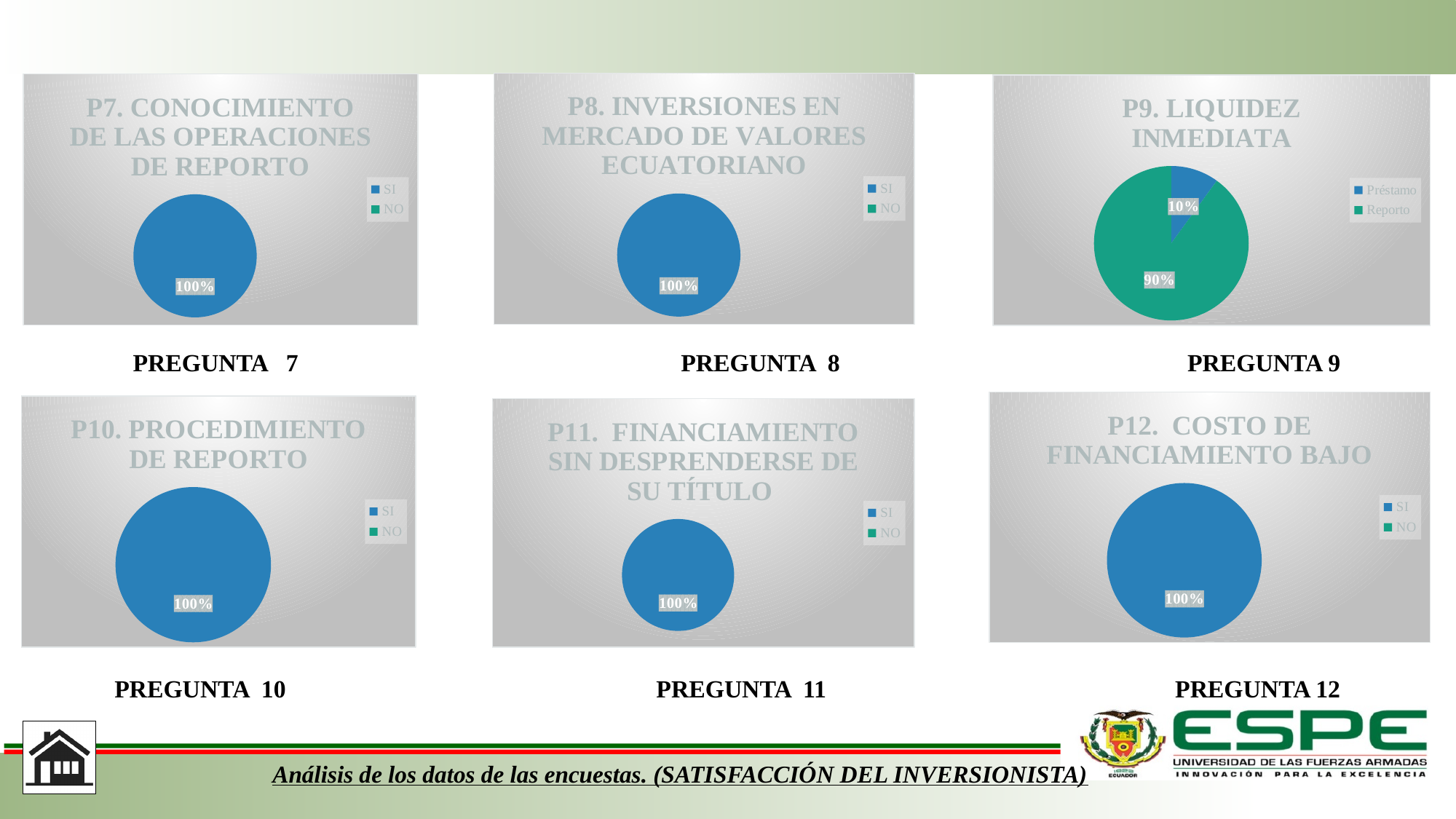
In the chart titled "P9. LIQUIDEZ INMEDIATA", which is larger, Préstamo or Reporto? Reporto In the chart titled "P12. COSTO DE FINANCIAMIENTO BAJO", what percentage is shown for SI? 100% In the chart titled "P7. CONOCIMIENTO DE LAS OPERACIONES DE REPORTO", what percentage is shown for SI? 100% In the chart titled "P9. LIQUIDEZ INMEDIATA", what percentage is shown for Reporto? 90% What kind of chart is used for "P8. INVERSIONES EN MERCADO DE VALORES ECUATORIANO"? Pie chart How many entries does the legend list in the chart titled "P10. PROCEDIMIENTO DE REPORTO"? 2 In the chart titled "P9. LIQUIDEZ INMEDIATA", what is the difference between the Reporto and Préstamo shares? 80% How many pie charts are shown on the slide? 6 What are the legend entries in the chart titled "P9. LIQUIDEZ INMEDIATA"? Préstamo and Reporto In the chart titled "P9. LIQUIDEZ INMEDIATA", which category has the smallest share? Préstamo In the chart titled "P9. LIQUIDEZ INMEDIATA", which category has the largest share? Reporto In the chart titled "P9. LIQUIDEZ INMEDIATA", what percentage is shown for Préstamo? 10%